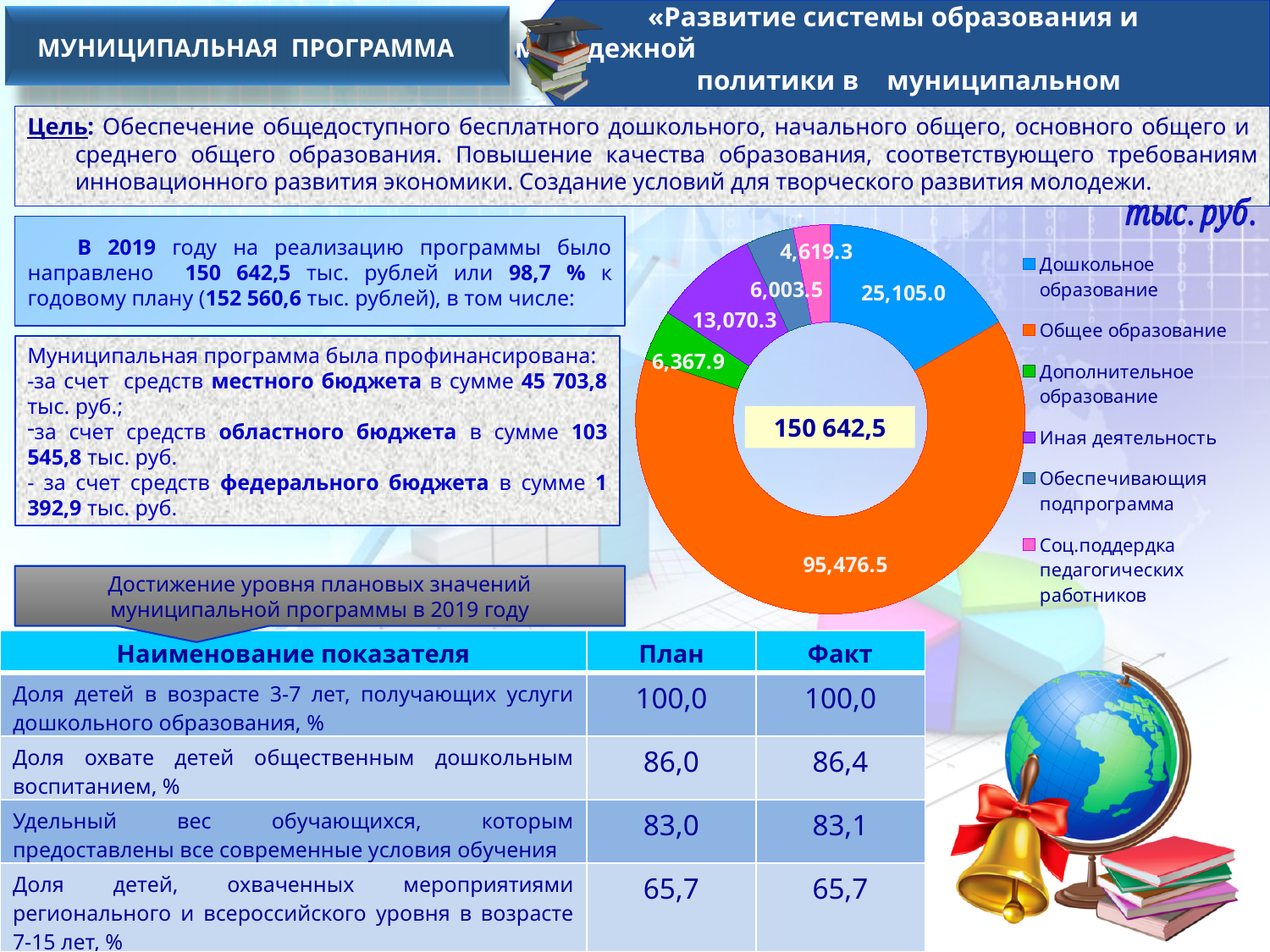
What total value is printed in the centre of the doughnut chart? 150 642,5 Which is larger in the doughnut chart: Иная деятельность or Дополнительное образование? Иная деятельность What is the value for Соц.поддержка педагогических работников in the doughnut chart? 4,619.3 What is the difference between the values for Общее образование and Дошкольное образование in the doughnut chart? 70,371.5 What kind of chart is shown on the slide? doughnut chart What is the value for Обеспечивающая подпрограмма in the doughnut chart? 6,003.5 What is the value for Общее образование in the doughnut chart? 95,476.5 What is the value for Иная деятельность in the doughnut chart? 13,070.3 Which category has the largest segment in the doughnut chart? Общее образование What is the value for Дошкольное образование in the doughnut chart? 25,105.0 Which category has the smallest segment in the doughnut chart? Соц.поддержка педагогических работников How many categories does the legend of the doughnut chart list? 6